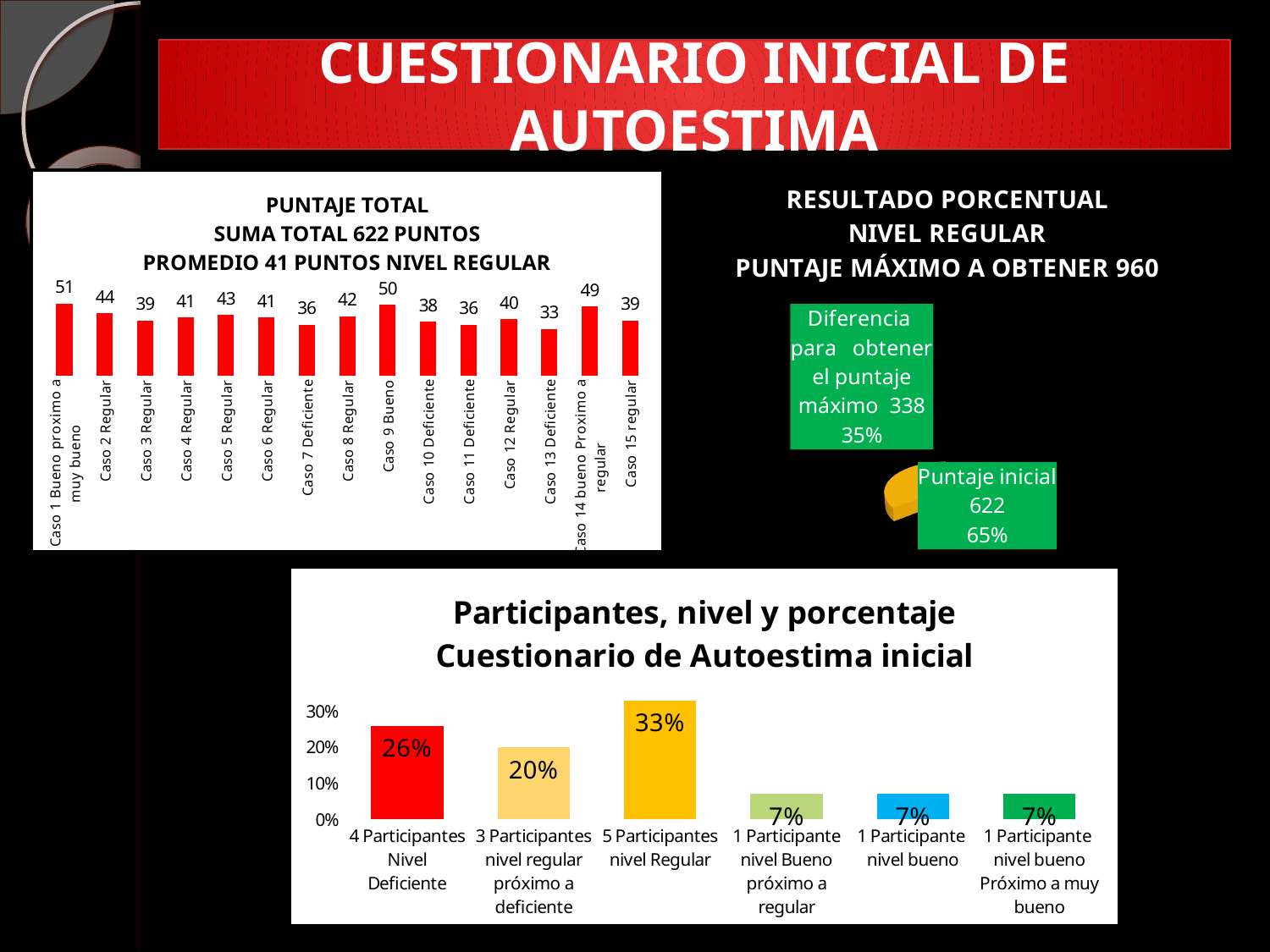
In the 'Participantes, nivel y porcentaje' chart, which category has the highest value? 5 Participantes nivel Regular In the 'PUNTAJE TOTAL' bar chart, what is the value for Caso 9 Bueno? 50 In the 'RESULTADO PORCENTUAL NIVEL REGULAR' pie chart, what share does 'Puntaje inicial 622' represent? 65% In the 'RESULTADO PORCENTUAL NIVEL REGULAR' pie chart, what share does 'Diferencia para obtener el puntaje máximo 338' represent? 35% In the 'PUNTAJE TOTAL' bar chart, which is larger, Caso 2 Regular or Caso 3 Regular? Caso 2 Regular What kind of chart is the 'Participantes, nivel y porcentaje' chart at the bottom of the slide? Bar chart In the 'PUNTAJE TOTAL' bar chart, what is the difference between Caso 1 and Caso 13? 18 How many cases are plotted in the 'PUNTAJE TOTAL' bar chart? 15 In the 'Participantes, nivel y porcentaje' chart, what is the value for '5 Participantes nivel Regular'? 33% In the 'PUNTAJE TOTAL' bar chart, which case has the lowest value? Caso 13 Deficiente In the 'PUNTAJE TOTAL' bar chart, which case has the highest value? Caso 1 Bueno proximo a muy bueno In the 'PUNTAJE TOTAL' bar chart, what is the value for Caso 7 Deficiente? 36